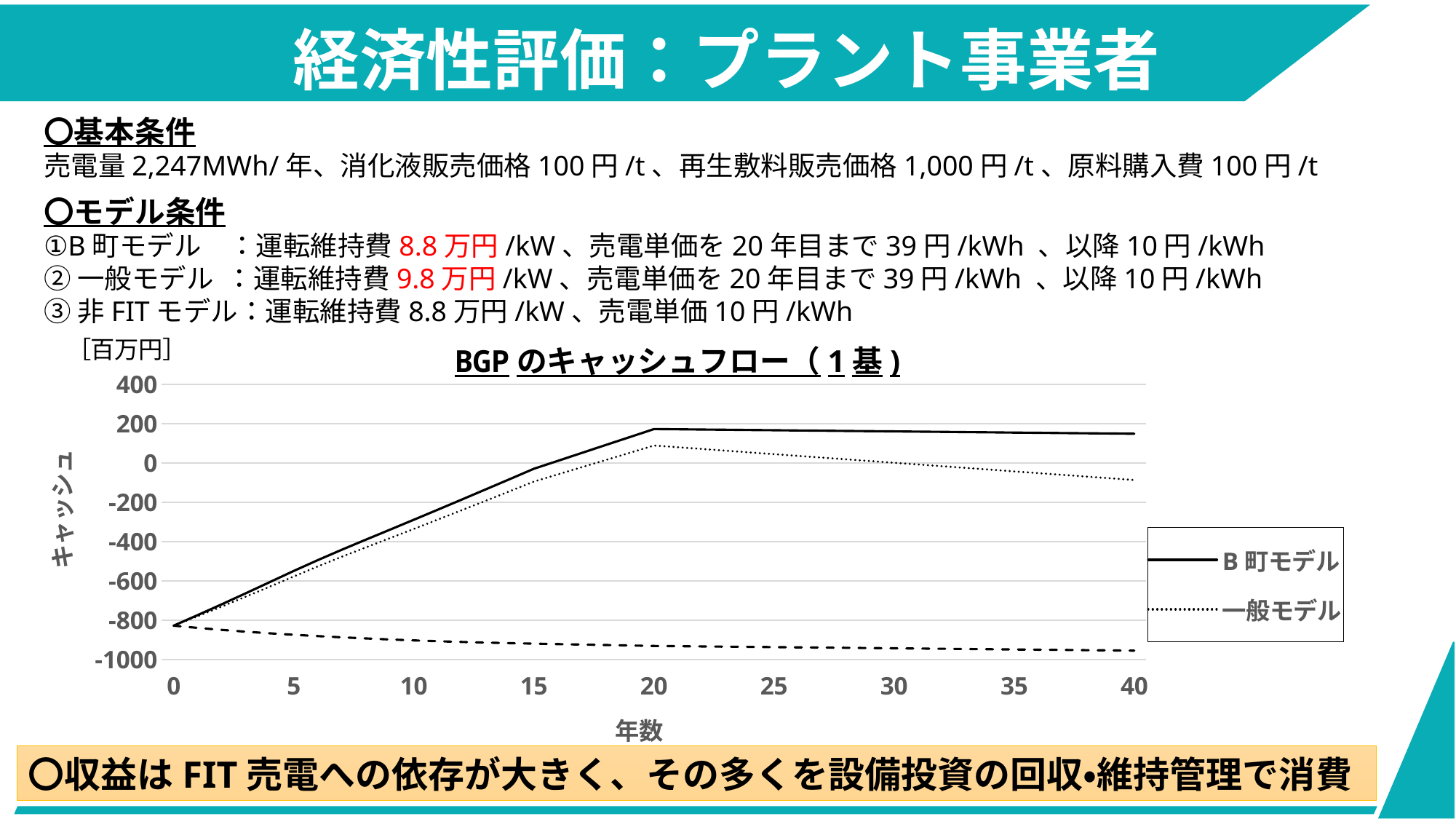
What is the title of the chart? BGPのキャッシュフロー（1基） Is the value for B町モデル at year 0 greater or less than -600? less What kind of chart is shown on the slide? line chart How many series does the chart legend list? 2 At year 40, which series has the higher value, B町モデル or 一般モデル? B町モデル Is the value for B町モデル at year 20 greater or less than 0? greater Is the value for 一般モデル at year 20 greater or less than 200? less Does the 一般モデル line rise or fall between year 20 and year 40? fall Does the B町モデル line rise or fall between year 0 and year 20? rise What is the label of the x axis of the chart? 年数